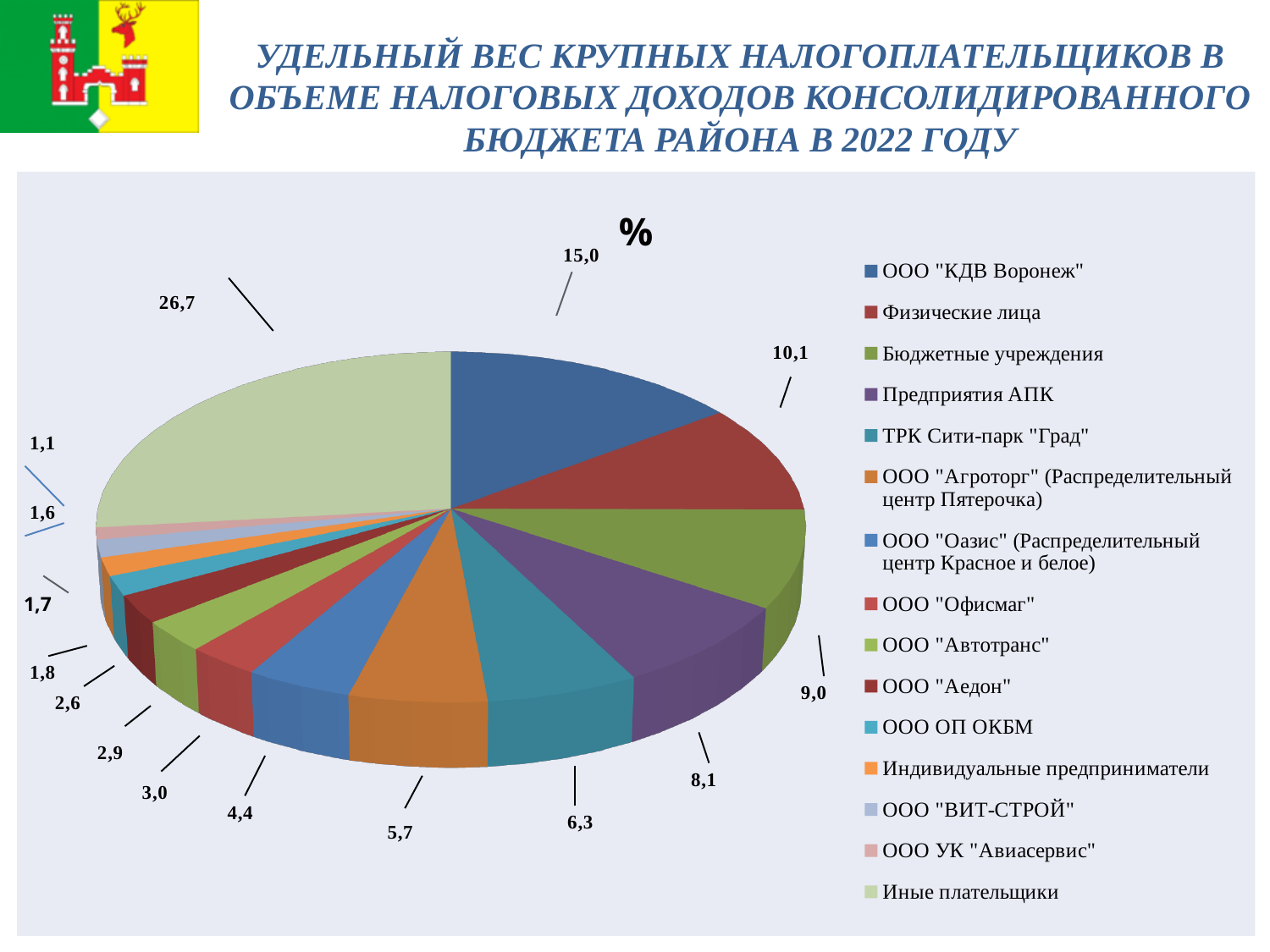
How many categories does the legend list? 15 What is the value for ООО "Агроторг" (Распределительный центр Пятерочка)? 5,7 Which is larger, the value for Бюджетные учреждения or the value for ТРК Сити-парк "Град"? Бюджетные учреждения Which category has the smallest share of the pie? ООО УК "Авиасервис" What is the difference between the values for ООО "КДВ Воронеж" and Физические лица? 4,9 What type of chart is shown on the slide? pie chart What is the value for ООО "КДВ Воронеж"? 15,0 What is the value for Предприятия АПК? 8,1 What is the value for Иные плательщики? 26,7 What unit is shown in the chart title above the pie? % What is the value for Физические лица? 10,1 Which category has the largest share of the pie? Иные плательщики